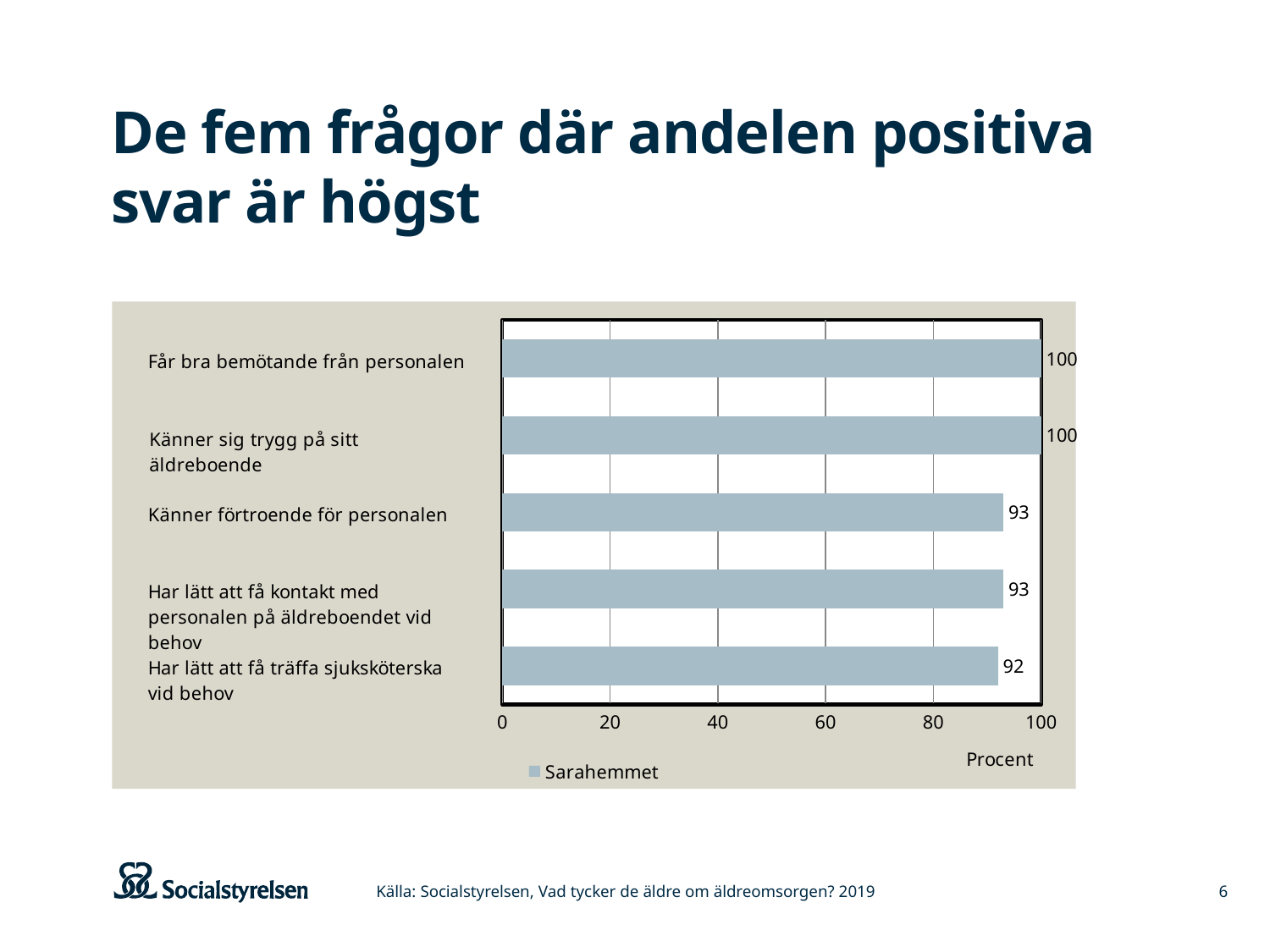
What is the value for "Har lätt att få träffa sjuksköterska vid behov"? 92 What is the value for "Känner sig trygg på sitt äldreboende"? 100 Which is larger: the value for "Känner sig trygg på sitt äldreboende" or the value for "Känner förtroende för personalen"? Känner sig trygg på sitt äldreboende What is the name of the series shown in the legend? Sarahemmet How many series does the legend list? 1 Which category has the lowest value? Har lätt att få träffa sjuksköterska vid behov Is the value for "Har lätt att få kontakt med personalen på äldreboendet vid behov" greater or less than 80? greater What is the value for "Känner förtroende för personalen"? 93 How many categories are shown in the chart? 5 What kind of chart is shown on the slide? bar chart What is the difference between the value for "Får bra bemötande från personalen" and the value for "Har lätt att få träffa sjuksköterska vid behov"? 8 What is the value for "Får bra bemötande från personalen"? 100